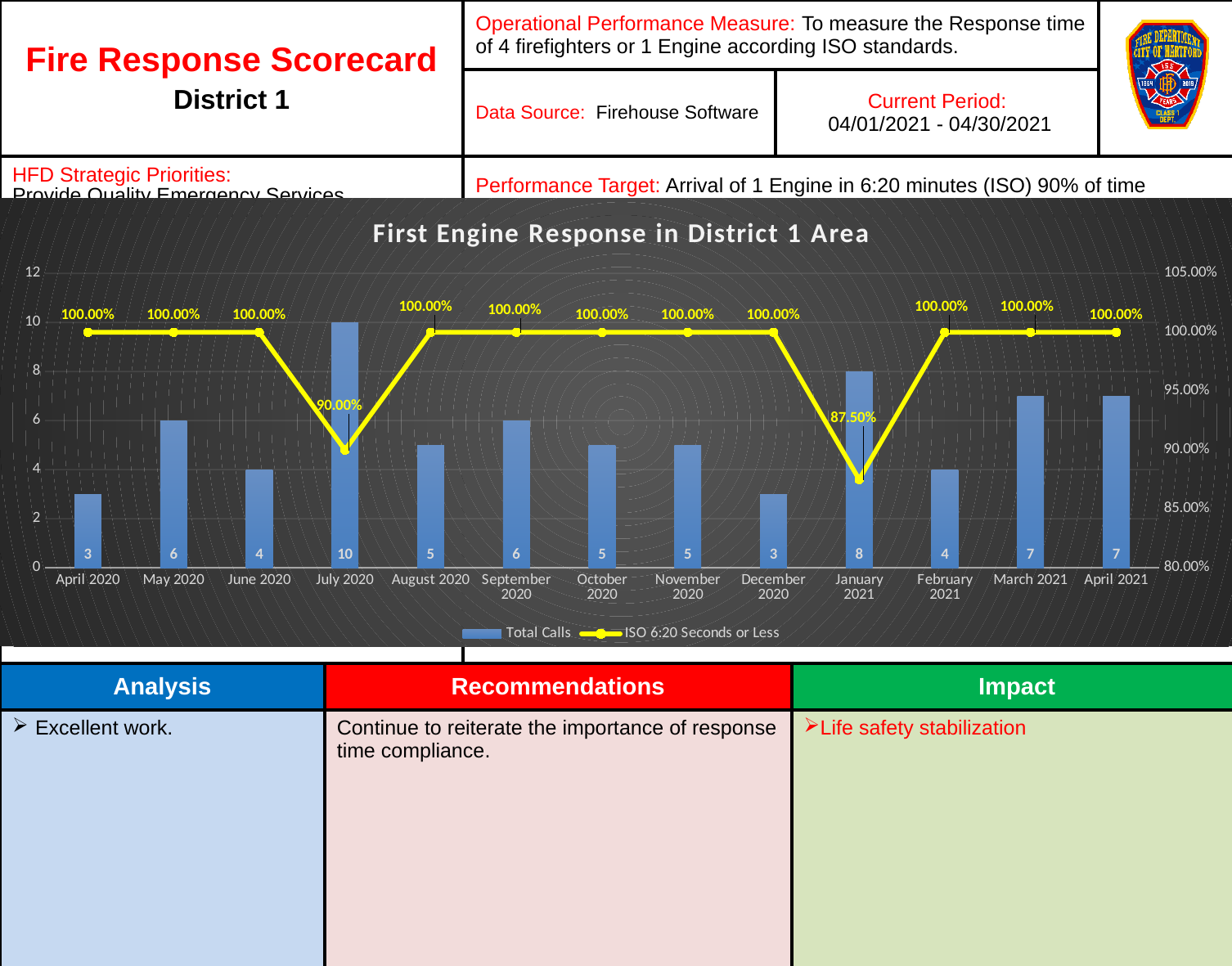
How many Total Calls were there in January 2021? 8 What is the ISO 6:20 Seconds or Less value for July 2020? 90.00% Which month has the lowest ISO 6:20 Seconds or Less value? January 2021 How many Total Calls were there in July 2020? 10 Which month has the highest number of Total Calls? July 2020 How many months are shown on the x axis? 13 Which has more Total Calls, March 2021 or February 2021? March 2021 What kind of chart is used for the Total Calls series? Bar chart How many series does the legend list? 2 What is the title of the chart? First Engine Response in District 1 Area What is the difference in Total Calls between July 2020 and April 2020? 7 What is the ISO 6:20 Seconds or Less value for January 2021? 87.50%